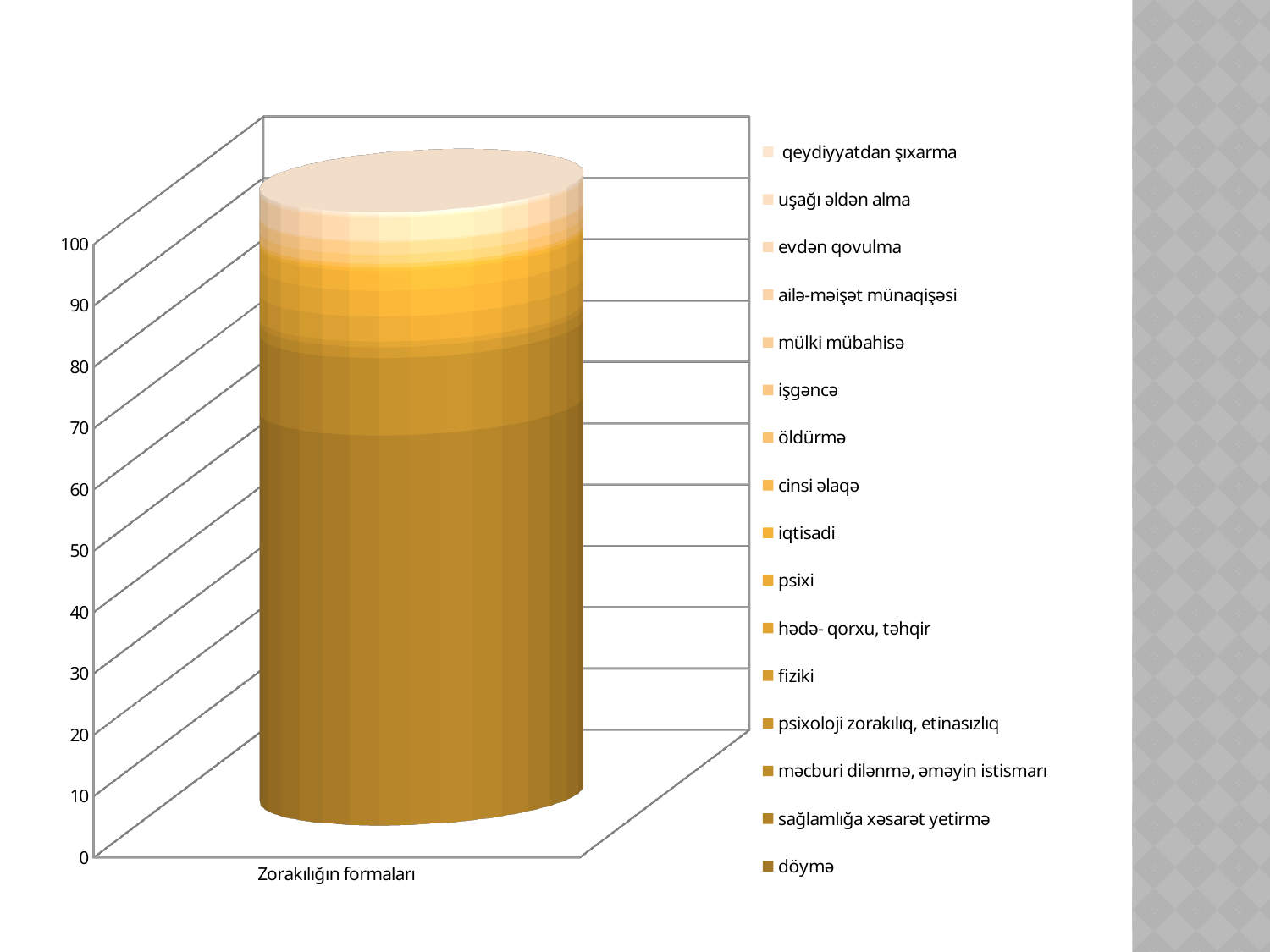
Is the value for öldürmə greater or less than 20? less How many categories are plotted on the x axis? 1 What is the highest value shown on the vertical axis? 100 What is the label of the category on the x axis? Zorakılığın formaları What kind of chart is shown on the slide? bar chart Which is larger, the segment for döymə or the segment for fiziki? döymə Which series forms the largest segment of the stacked bar? döymə How many series does the legend list? 16 Which series is listed first in the legend? qeydiyyatdan şıxarma Is the value for döymə greater or less than 50? greater